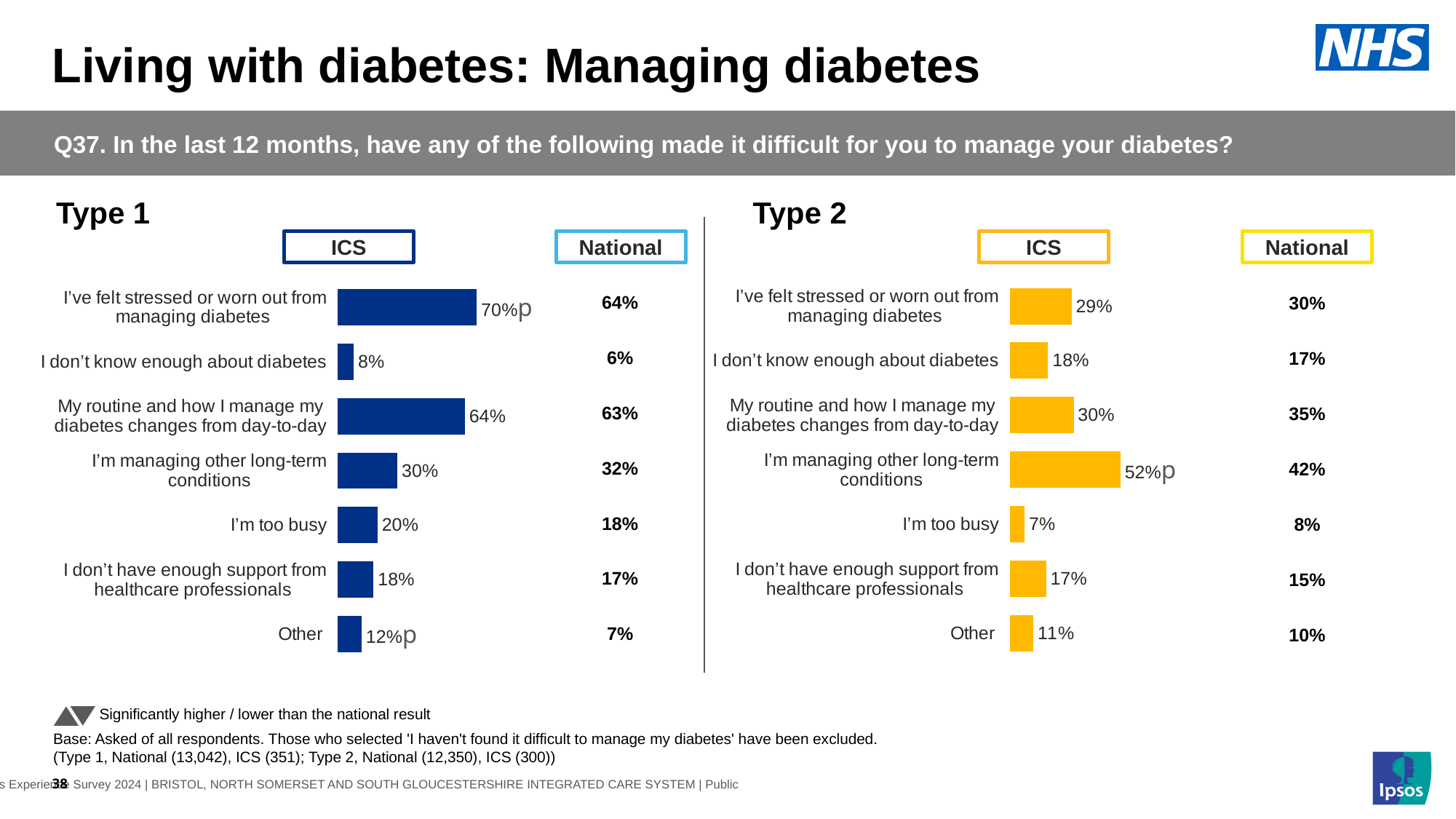
On the Type 1 chart, what is the National value for 'Other'? 7% On the Type 1 chart, what is the difference between the ICS and National values for 'I don't know enough about diabetes'? 2 percentage points What type of chart is used for the ICS values on the Type 1 chart? bar chart On the Type 2 chart, what is the National value for 'My routine and how I manage my diabetes changes from day-to-day'? 35% On the Type 1 chart, which category has the highest ICS value? I've felt stressed or worn out from managing diabetes On the Type 1 chart, what is the ICS value for 'I've felt stressed or worn out from managing diabetes'? 70% On the Type 2 chart, what is the ICS value for 'I'm managing other long-term conditions'? 52% On the Type 2 chart, which category has the lowest ICS value? I'm too busy How many categories are shown on the Type 2 chart? 7 On the Type 1 chart, is the ICS value for 'I'm too busy' larger or smaller than the ICS value for 'I don't have enough support from healthcare professionals'? larger What colour are the ICS bars on the Type 2 chart? yellow On the Type 2 chart, what is the difference between the ICS and National values for 'I'm managing other long-term conditions'? 10 percentage points